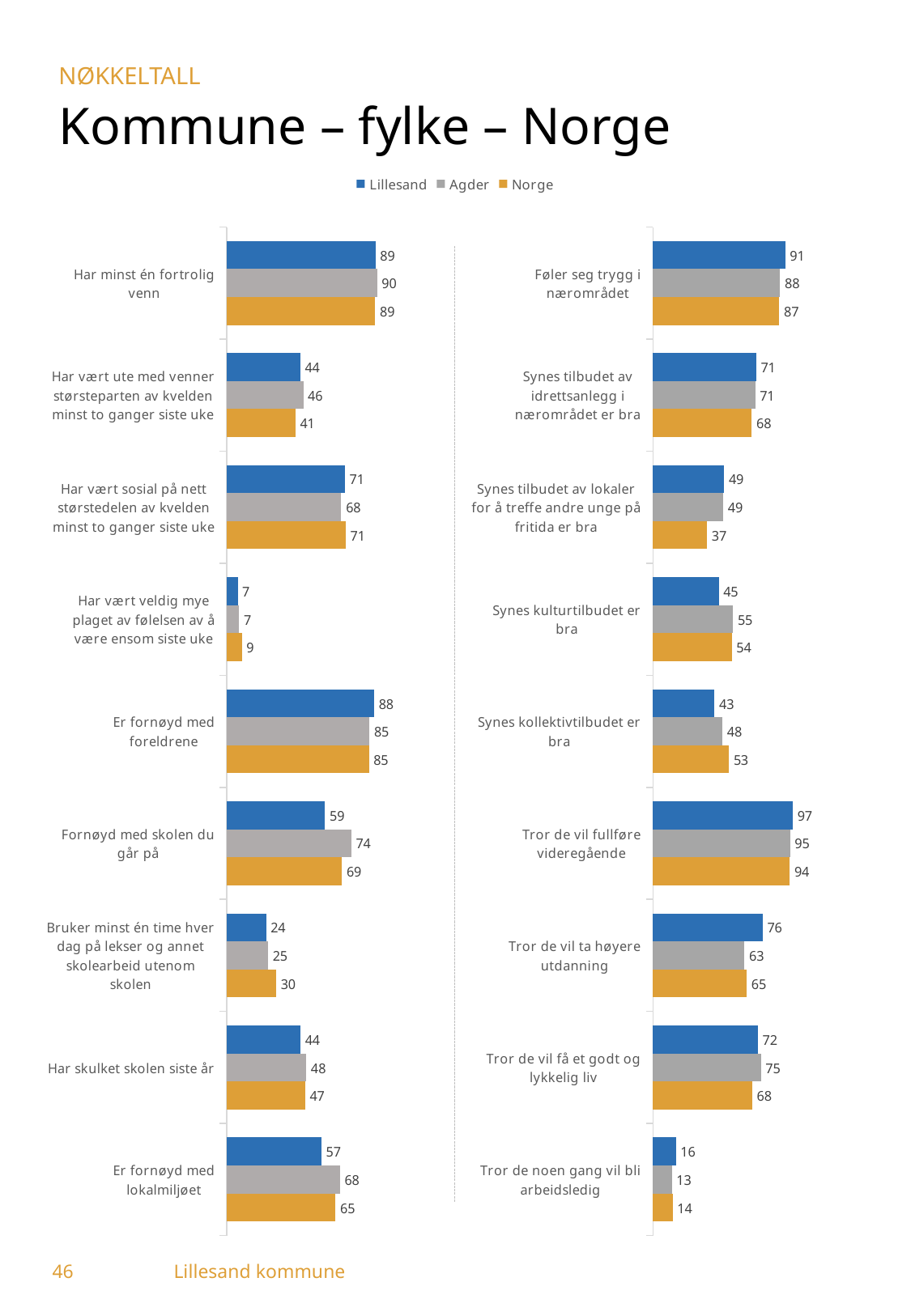
On the right chart, what is the difference between the Lillesand and Agder values for 'Tror de vil ta høyere utdanning'? 13 On the right chart, what is the difference between the Agder and Lillesand values for 'Synes kulturtilbudet er bra'? 10 Which colour represents Norge in the legend? Orange How many series does the legend list? 3 On the right chart, which category has the highest Lillesand value? Tror de vil fullføre videregående On the left chart, what is the value for Agder for 'Fornøyd med skolen du går på'? 74 On the left chart, which is larger for 'Er fornøyd med lokalmiljøet': the Lillesand value or the Agder value? Agder How many categories does the left chart show? 9 On the left chart, which category has the lowest Norge value? Har vært veldig mye plaget av følelsen av å være ensom siste uke On the right chart, what is the value for Norge for 'Synes tilbudet av lokaler for å treffe andre unge på fritida er bra'? 37 On the left chart, what is the value for Lillesand for 'Har minst én fortrolig venn'? 89 What type of chart is used on this slide? Bar chart